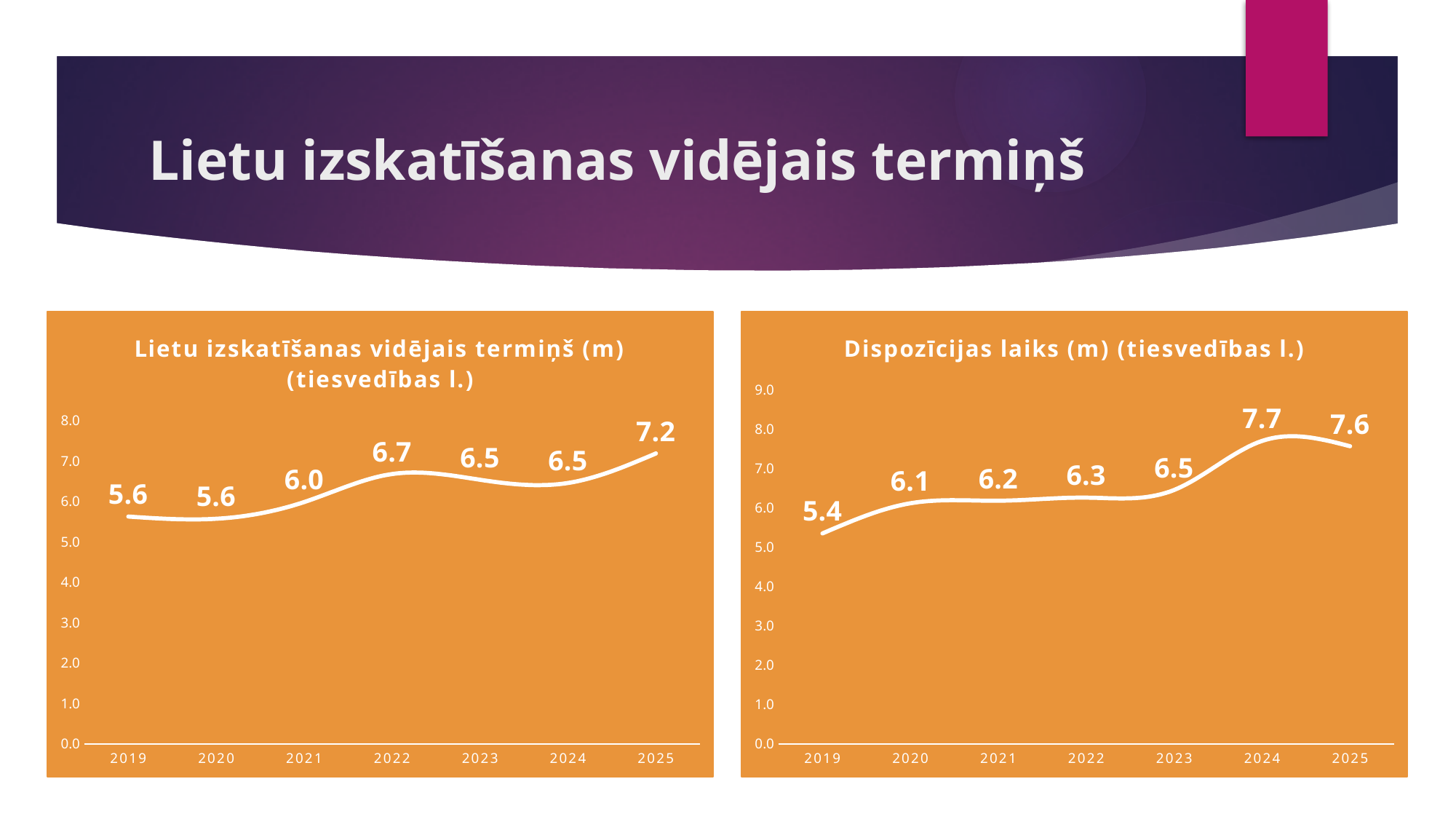
In the left chart (Lietu izskatīšanas vidējais termiņš (m) (tiesvedības l.)), what is the difference between the values for 2025 and 2019? 1.6 In the right chart (Dispozīcijas laiks (m) (tiesvedības l.)), which year has the lowest value? 2019 In the left chart (Lietu izskatīšanas vidējais termiņš (m) (tiesvedības l.)), which year has the highest value? 2025 In the right chart (Dispozīcijas laiks (m) (tiesvedības l.)), do the values generally rise or fall from 2019 to 2024? rise In the right chart (Dispozīcijas laiks (m) (tiesvedības l.)), is the value for 2025 greater or less than 7.0? greater What kind of chart is the right chart (Dispozīcijas laiks (m) (tiesvedības l.))? line chart In the right chart (Dispozīcijas laiks (m) (tiesvedības l.)), what is the difference between the values for 2024 and 2023? 1.2 How many years are plotted on the x axis of the left chart (Lietu izskatīšanas vidējais termiņš (m) (tiesvedības l.))? 7 In the right chart (Dispozīcijas laiks (m) (tiesvedības l.)), which year has the highest value? 2024 In the left chart (Lietu izskatīšanas vidējais termiņš (m) (tiesvedības l.)), which is larger, the value for 2021 or the value for 2022? 2022 In the left chart (Lietu izskatīšanas vidējais termiņš (m) (tiesvedības l.)), what is the value for 2022? 6.7 In the right chart (Dispozīcijas laiks (m) (tiesvedības l.)), what is the value for 2019? 5.4